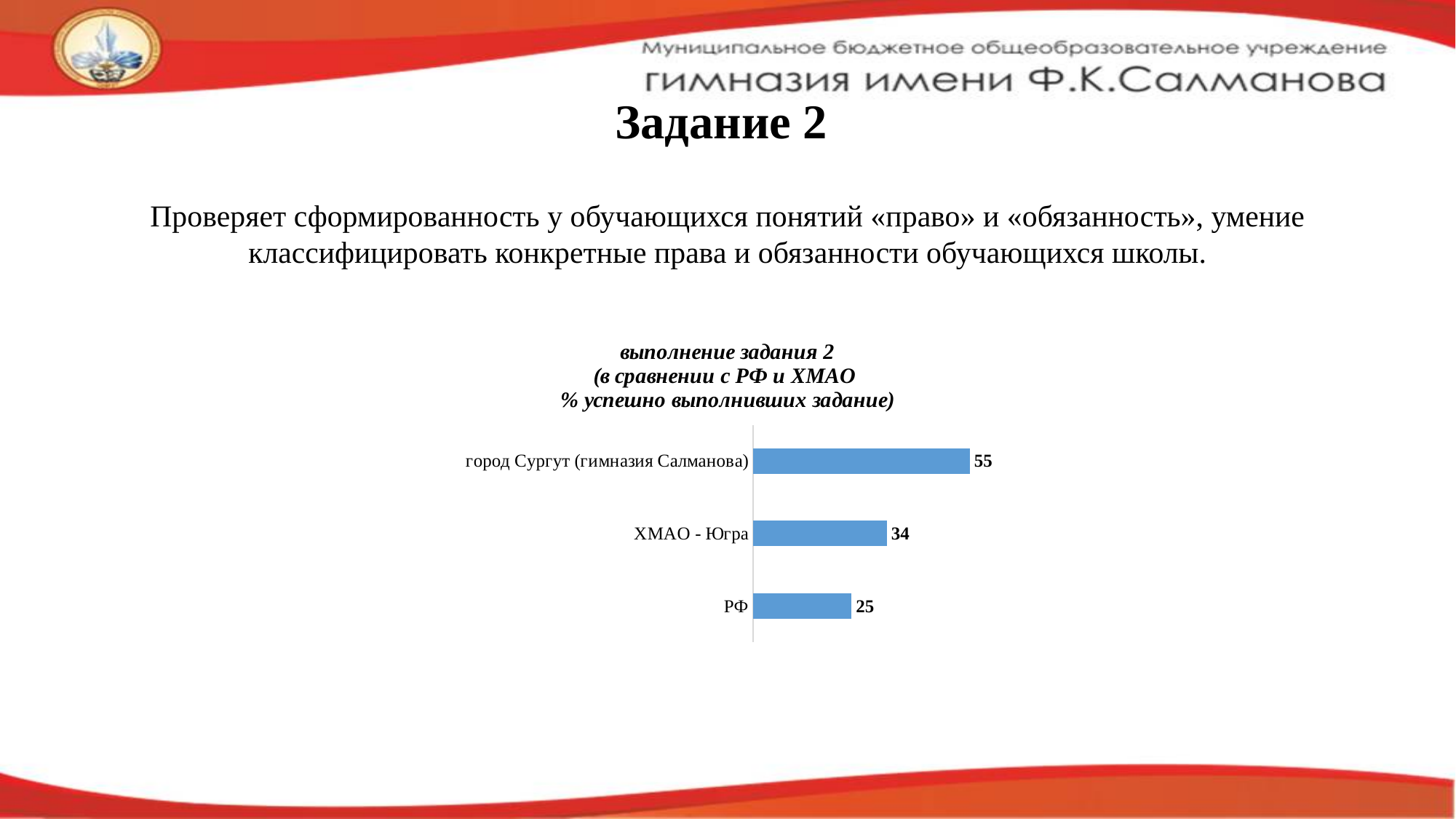
Which is larger, the value for ХМАО - Югра or the value for РФ? ХМАО - Югра What is the difference between the values for ХМАО - Югра and РФ? 9 What is the value for ХМАО - Югра? 34 What is the title of the chart? выполнение задания 2 (в сравнении с РФ и ХМАО % успешно выполнивших задание) How many categories are shown in the chart? 3 What kind of chart is shown on the slide? bar chart What is the value for РФ? 25 What is the value for город Сургут (гимназия Салманова)? 55 What colour are the bars in the chart? blue Which category has the lowest value? РФ Which category has the highest value? город Сургут (гимназия Салманова) What is the difference between the values for город Сургут (гимназия Салманова) and РФ? 30